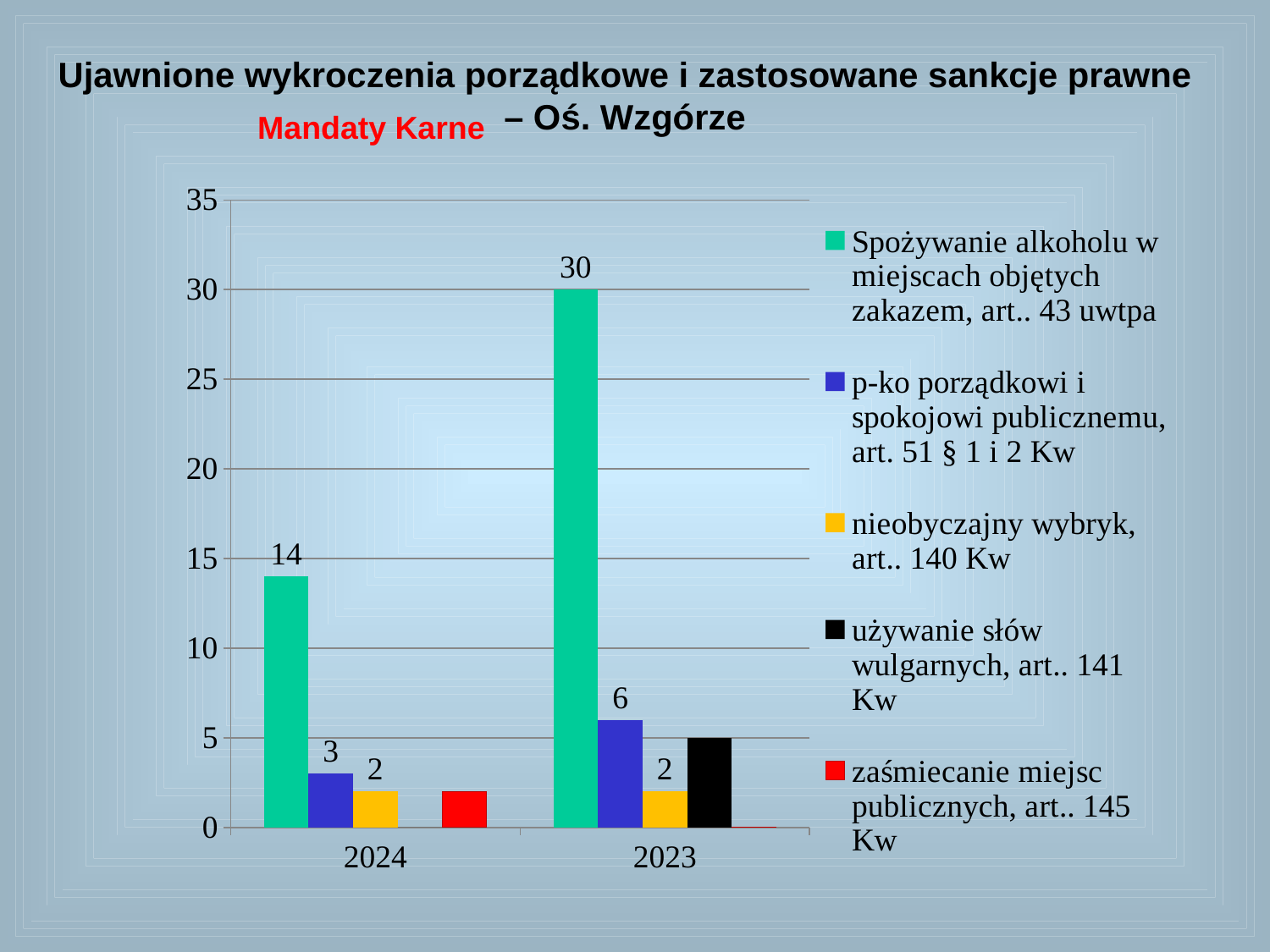
Is the value for 'używanie słów wulgarnych, art.. 141 Kw' in 2023 greater or less than 10? less How many series does the legend list? 5 What is the value for 'p-ko porządkowi i spokojowi publicznemu, art. 51 § 1 i 2 Kw' in 2023? 6 Which year has the larger value for 'p-ko porządkowi i spokojowi publicznemu', 2024 or 2023? 2023 By how much does the value for 'Spożywanie alkoholu w miejscach objętych zakazem' in 2023 exceed the value in 2024? 16 How many years are shown on the x axis? 2 What is the value for 'Spożywanie alkoholu w miejscach objętych zakazem, art.. 43 uwtpa' in 2023? 30 What is the value for 'p-ko porządkowi i spokojowi publicznemu, art. 51 § 1 i 2 Kw' in 2024? 3 What kind of chart is shown on the slide? bar chart What is the value for 'nieobyczajny wybryk, art.. 140 Kw' in 2024? 2 Which series has the highest value in 2023? Spożywanie alkoholu w miejscach objętych zakazem, art.. 43 uwtpa What is the value for 'Spożywanie alkoholu w miejscach objętych zakazem, art.. 43 uwtpa' in 2024? 14